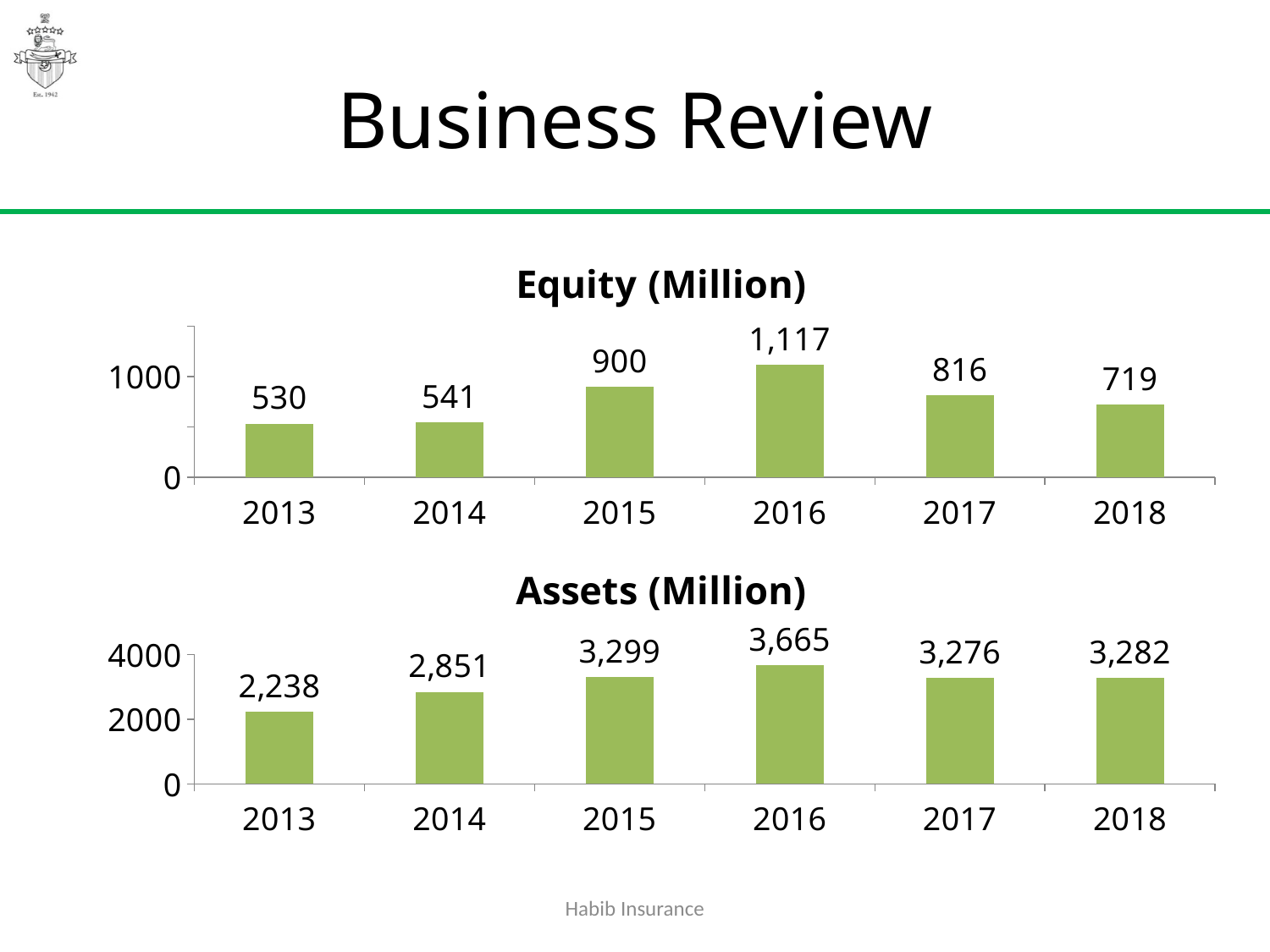
How many years are shown in the Assets (Million) chart? 6 In the Equity (Million) chart, what is the value for 2016? 1,117 In the Equity (Million) chart, what is the difference between the values for 2016 and 2018? 398 In the Assets (Million) chart, what is the value for 2014? 2,851 In the Equity (Million) chart, which year has the lowest value? 2013 In the Assets (Million) chart, what is the difference between the values for 2015 and 2013? 1,061 What kind of chart is the Equity (Million) chart? bar chart In the Equity (Million) chart, do the values rise or fall from 2016 to 2018? fall What is the title of the lower chart on the slide? Assets (Million) In the Assets (Million) chart, which year has the highest value? 2016 In the Equity (Million) chart, which is larger, the value for 2015 or the value for 2017? 2015 In the Assets (Million) chart, is the value for 2013 greater or less than 2000? greater